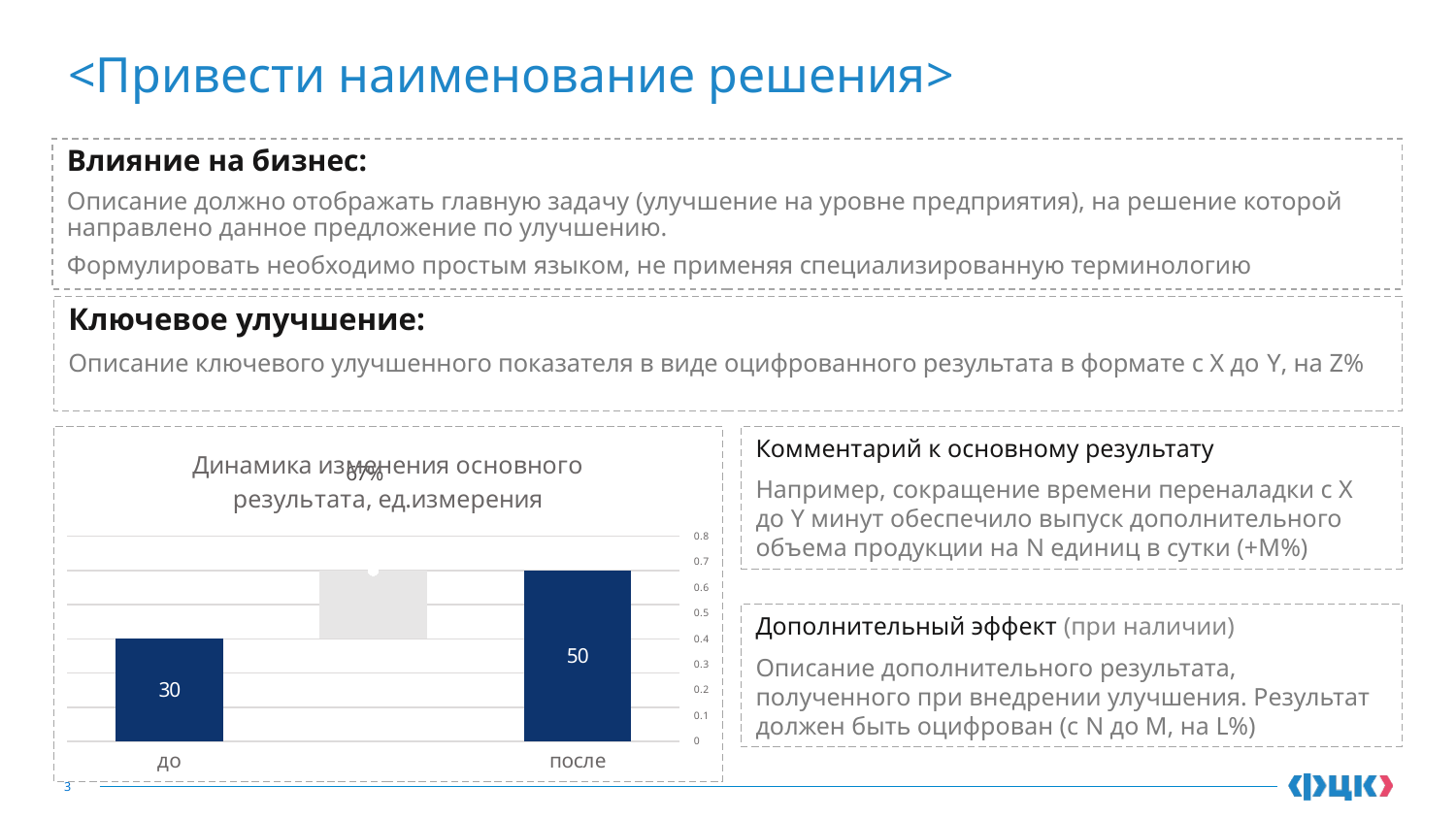
What is the difference between the values for "после" and "до"? 20 Do the values rise or fall from "до" to "после"? rise Which category has the highest value in the chart? после Which category has the lowest value in the chart? до Which is larger, the value for "до" or the value for "после"? после What is the title of the chart? Динамика изменения основного результата, ед.измерения What colour are the bars for "до" and "после"? dark blue What is the value for "до" in the chart? 30 How many categories are shown on the x axis of the chart? 2 What kind of chart is shown on the slide? bar chart What is the value for "после" in the chart? 50